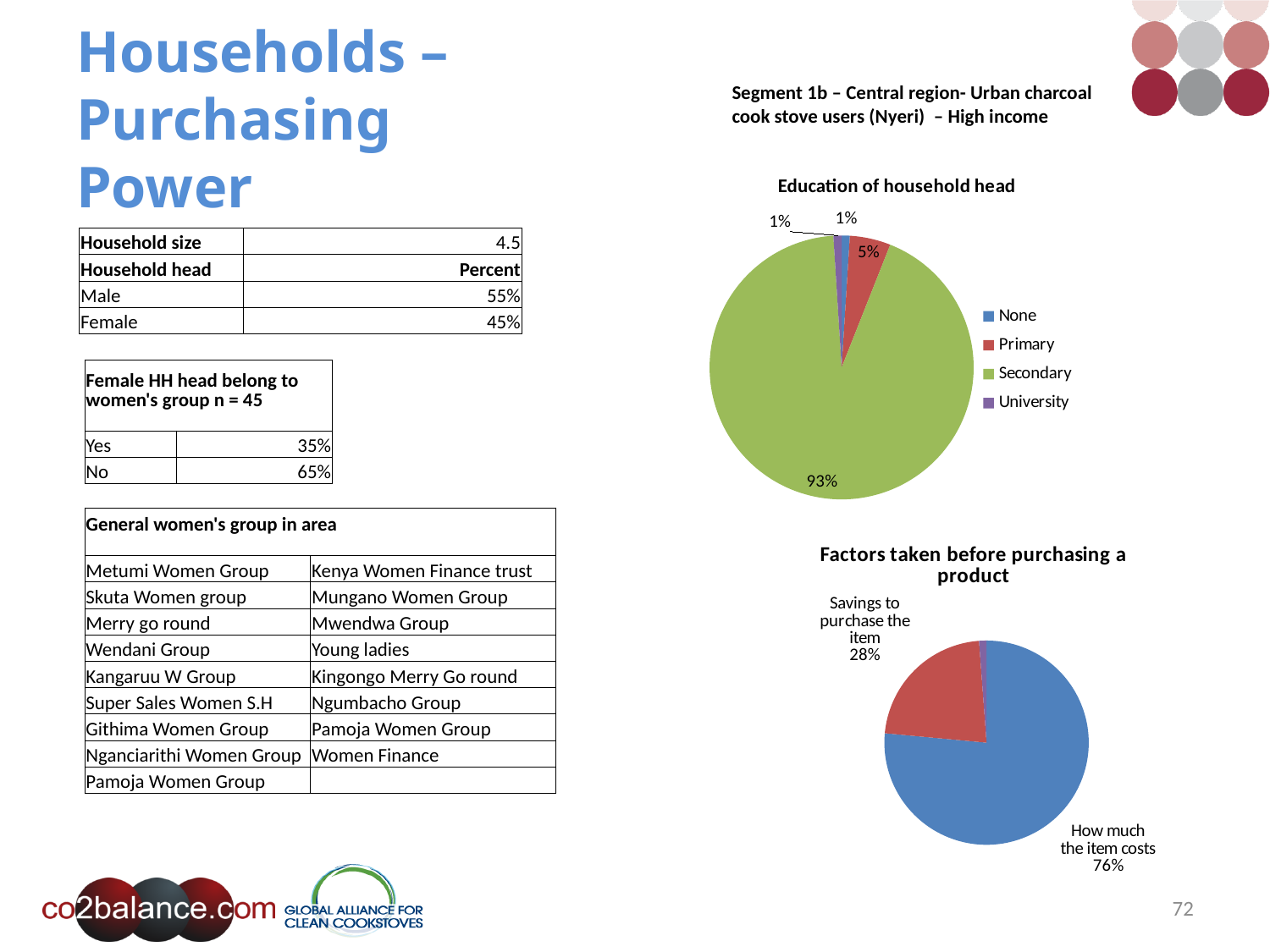
In the 'Education of household head' chart, what percentage of household heads have university education? 1% In the 'Education of household head' chart, what percentage of household heads have primary education? 5% In the 'Factors taken before purchasing a product' chart, which factor has the larger share? How much the item costs In the 'Education of household head' chart, which is larger, the Primary share or the None share? Primary In the 'Education of household head' chart, how many categories does the legend list? 4 In the 'Education of household head' chart, what colour represents the Secondary category? Green In the 'Factors taken before purchasing a product' chart, what percentage is shown for 'How much the item costs'? 76% In the 'Education of household head' chart, what percentage of household heads have secondary education? 93% In the 'Education of household head' chart, which education level has the largest share? Secondary In the 'Education of household head' chart, what is the difference between the Secondary and Primary shares? 88% In the 'Factors taken before purchasing a product' chart, what percentage is shown for 'Savings to purchase the item'? 28% What type of chart is 'Education of household head'? Pie chart